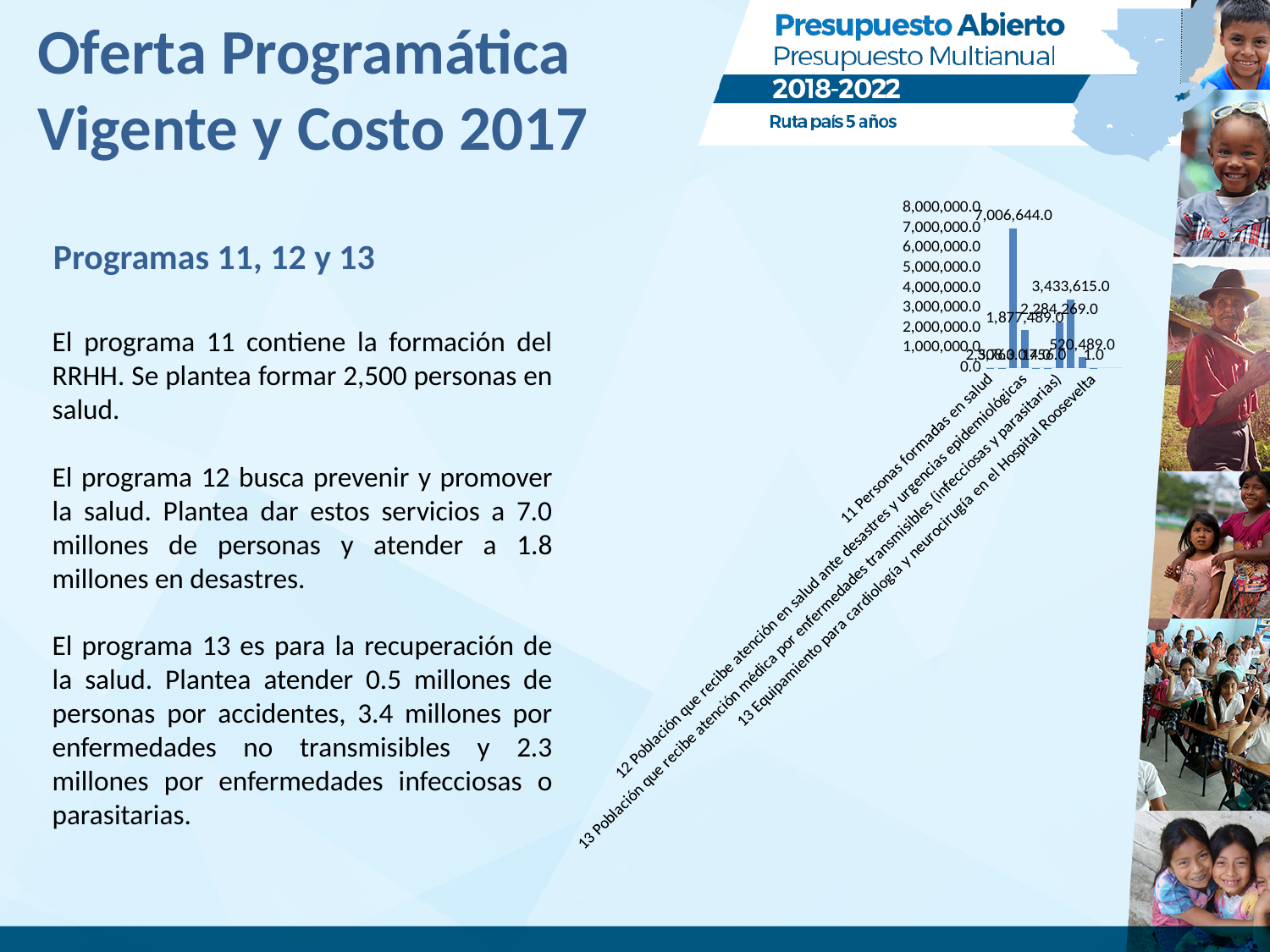
Is the tallest bar's value greater or less than 7,000,000.0? greater What is the difference between the highest labelled value, 7,006,644.0, and the value 3,433,615.0? 3,573,029.0 Which is larger, the bar labelled 3,433,615.0 or the bar labelled 2,284,269.0? 3,433,615.0 Is the bar labelled 520,489.0 greater or less than 1,000,000.0? less What is the highest value labelled on the chart? 7,006,644.0 Which is larger, the bar labelled 1,877,489.0 or the bar labelled 520,489.0? 1,877,489.0 What is the difference between the values labelled 2,284,269.0 and 1,877,489.0? 406,780.0 What is the difference between the values labelled 3,433,615.0 and 2,284,269.0? 1,149,346.0 What is the first category label on the chart's horizontal axis? 11 Personas formadas en salud What kind of chart is shown on the slide? bar chart What is the maximum value shown on the chart's vertical axis? 8,000,000.0